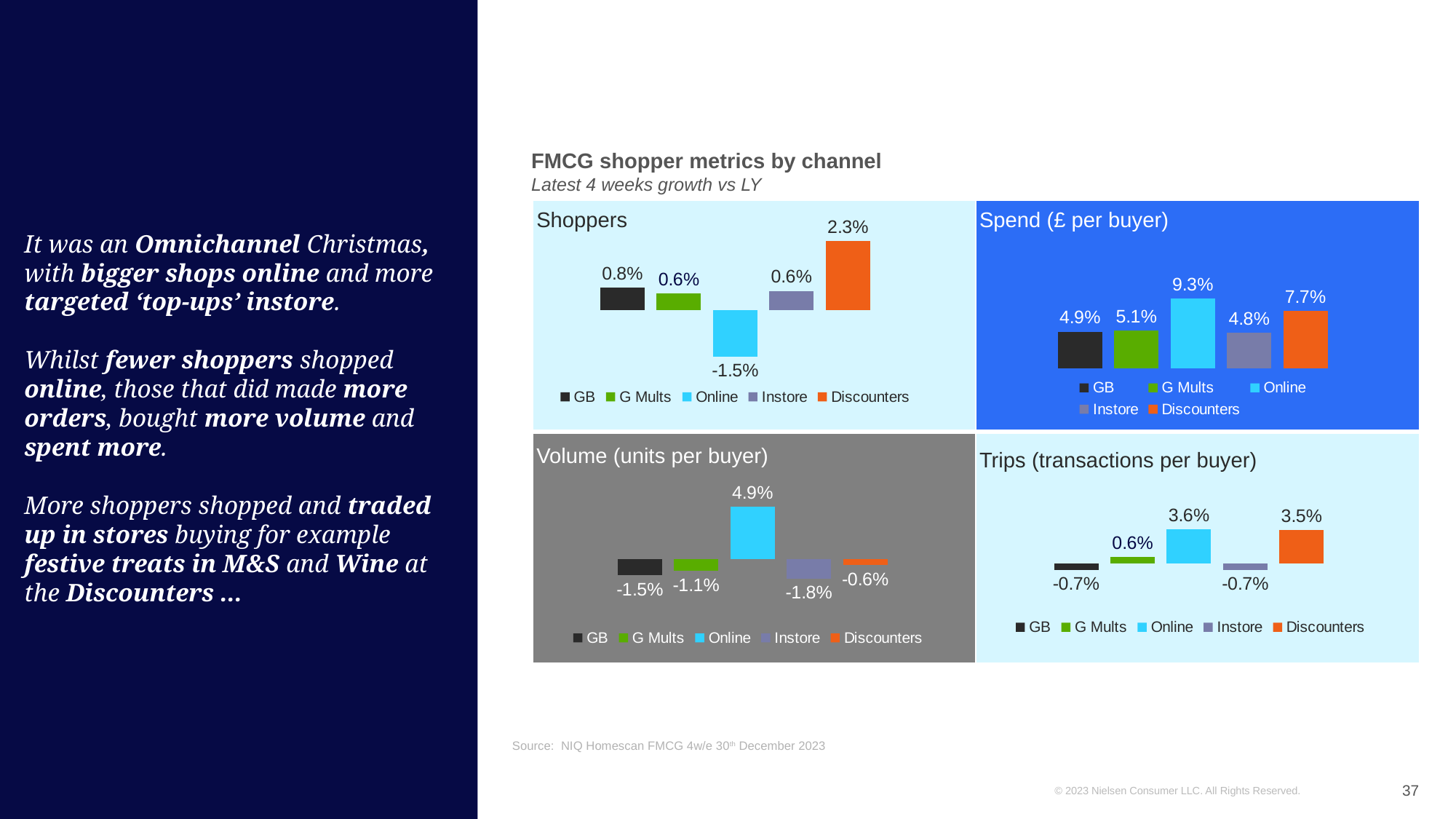
In the Volume (units per buyer) chart, which channel has the lowest value? Instore In the Spend (£ per buyer) chart, which channel has the highest value? Online What kind of chart is the Volume (units per buyer) chart? Bar chart In the Shoppers chart, what is the value for Discounters? 2.3% In the Spend (£ per buyer) chart, what is the difference between Online and Discounters? 1.6% How many series does the legend of the Shoppers chart list? 5 In the Trips (transactions per buyer) chart, what is the value for G Mults? 0.6% In the Spend (£ per buyer) chart, what is the value for Instore? 4.8% In the Volume (units per buyer) chart, what is the value for Online? 4.9% What is the subtitle shown under the title 'FMCG shopper metrics by channel'? Latest 4 weeks growth vs LY In the Trips (transactions per buyer) chart, which is larger, Online or G Mults? Online In the Shoppers chart, what is the value for Online? -1.5%